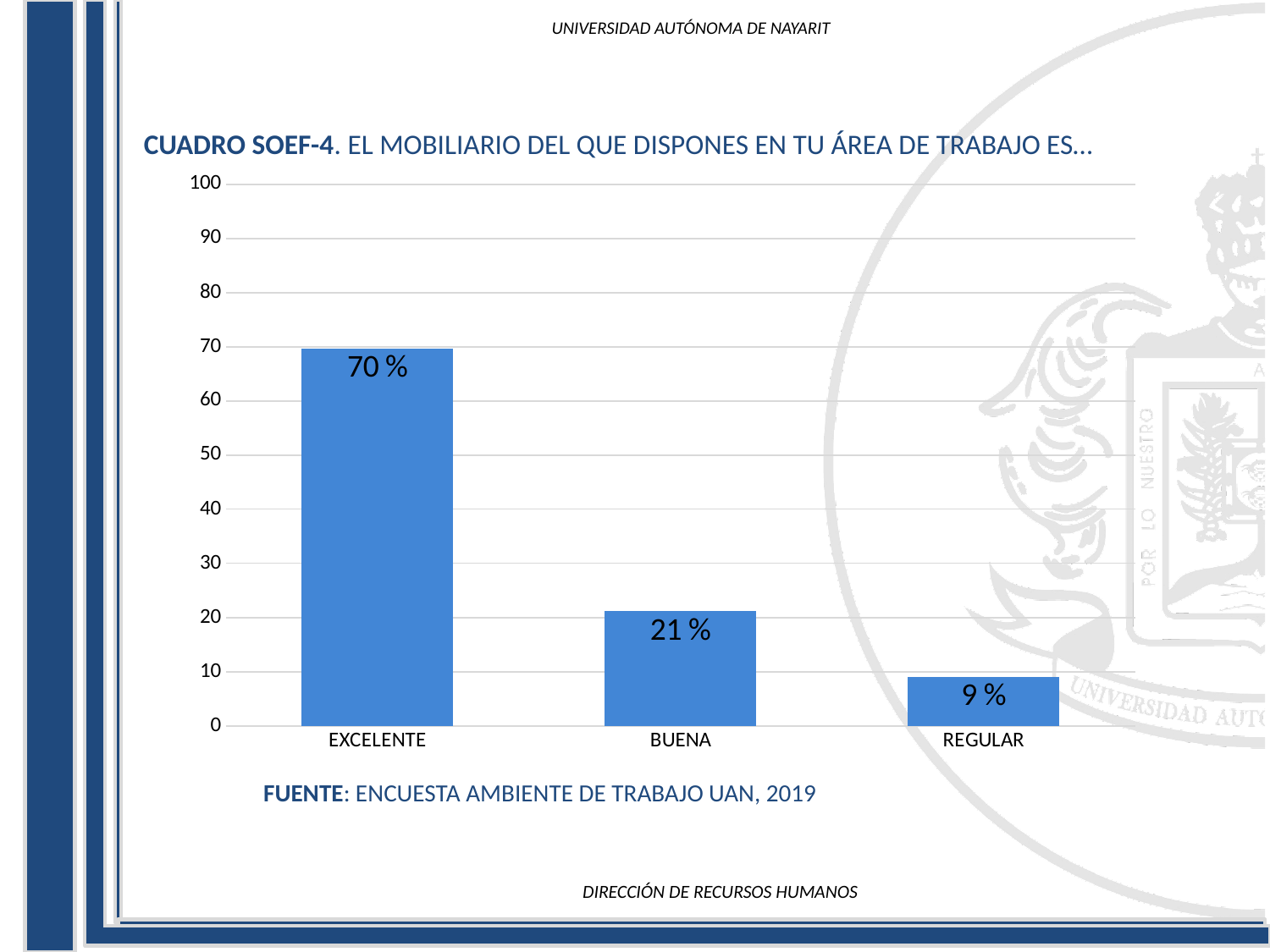
What is the value for BUENA? 21 % What is the value for REGULAR? 9 % What is the difference between the values for EXCELENTE and BUENA? 49 % How many categories are shown on the x axis? 3 Which is larger, the value for BUENA or the value for REGULAR? BUENA What kind of chart is shown on the slide? bar chart Do the values rise or fall from left to right along the x axis? fall What is the value for EXCELENTE? 70 % Is the value for BUENA greater or less than 30? less Which category has the highest value? EXCELENTE Which category has the lowest value? REGULAR What is the difference between the values for BUENA and REGULAR? 12 %